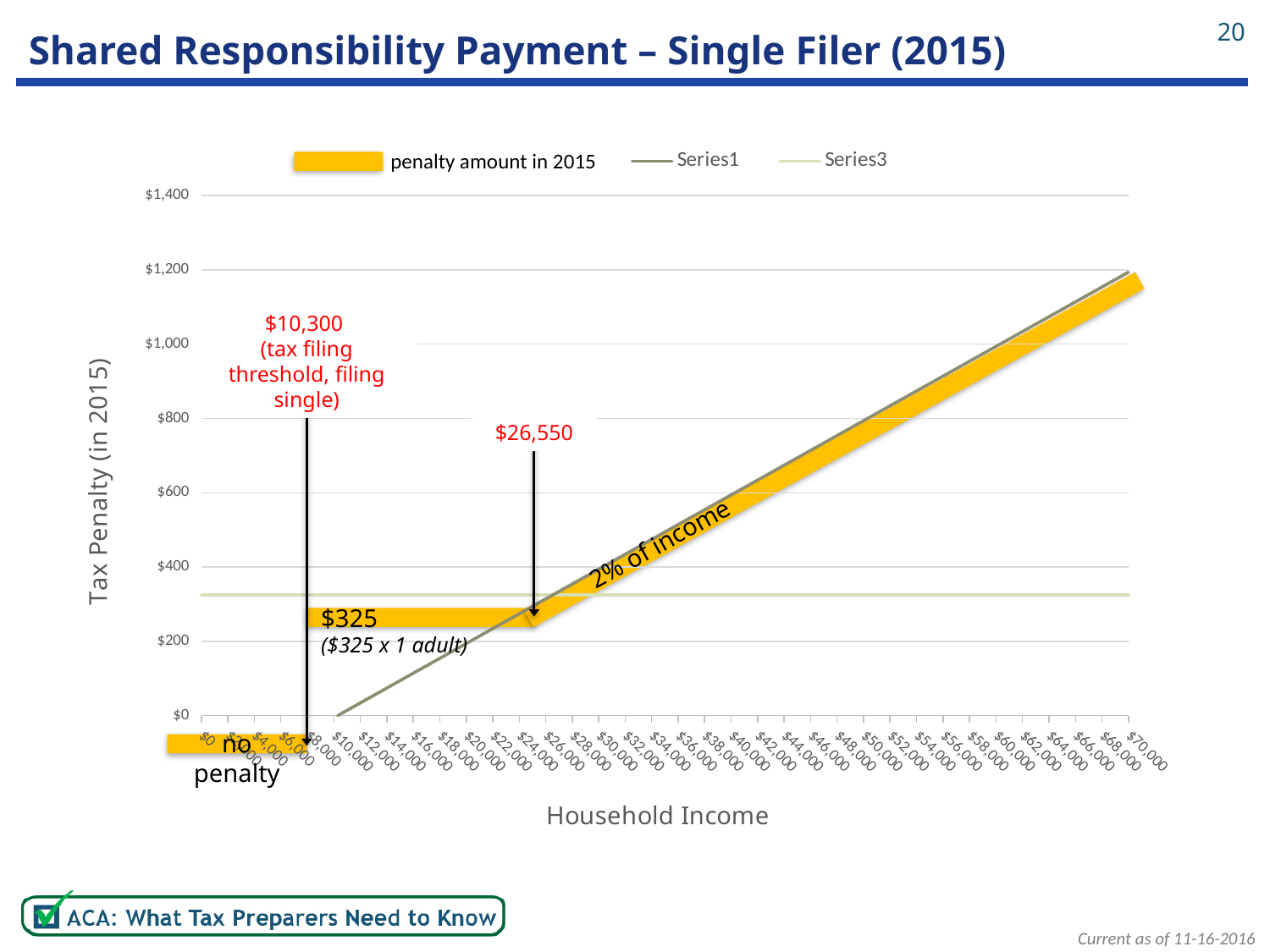
What is the flat penalty amount labeled on the chart for a single filer? $325 How many series does the chart legend list? 3 At what household income does the chart mark the tax filing threshold for filing single? $10,300 Is the penalty amount at a household income of $30,000 greater or less than $600? less Is the penalty amount at a household income of $70,000 greater or less than $1,000? greater Is the penalty amount at a household income of $40,000 greater or less than $800? less What is the title of the y axis of the chart? Tax Penalty (in 2015) What kind of chart is shown on the slide? line chart What is the highest value shown on the y axis of the chart? $1,400 Does the penalty amount rise or fall as household income increases beyond $26,550? rises At what household income does the chart mark the point where the penalty switches from the flat amount to 2% of income? $26,550 What is the title of the x axis of the chart? Household Income